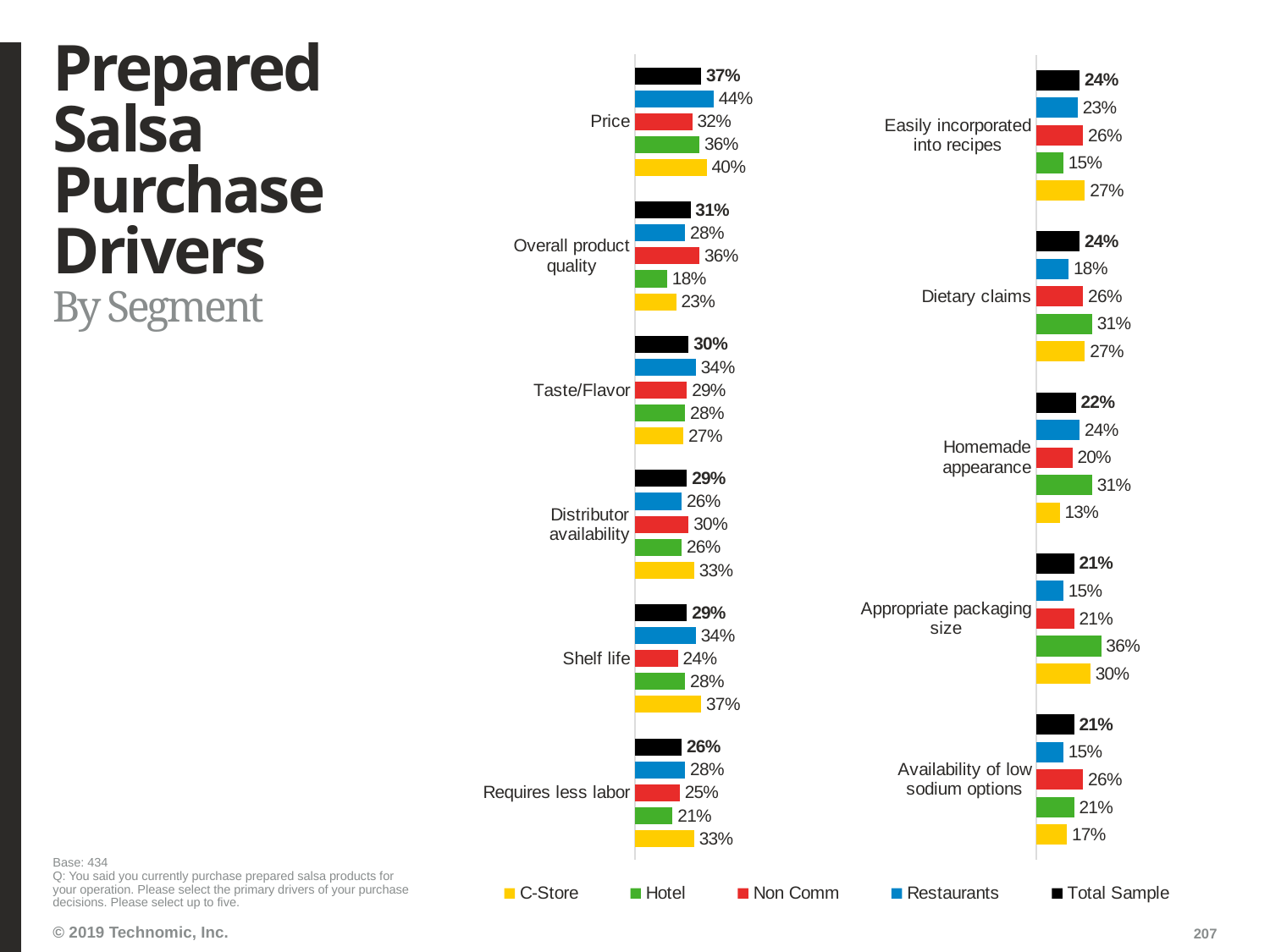
In the left chart, what is the difference between the Restaurants and Non Comm values for Price? 12% What type of chart is used on this slide? Bar chart In the right chart, what is the C-Store value for Homemade appearance? 13% In the right chart, what is the Total Sample value for Dietary claims? 24% How many categories are shown in the right chart? 5 In the left chart, which segment has the highest value for Shelf life? C-Store In the left chart, what is the Restaurants value for Price? 44% In the left chart, what is the Hotel value for Overall product quality? 18% How many categories are shown in the left chart? 6 In the right chart, which segment has the lowest value for Appropriate packaging size? Restaurants How many series does the legend list? 5 In the right chart, which is larger for Availability of low sodium options: the Non Comm value or the C-Store value? Non Comm